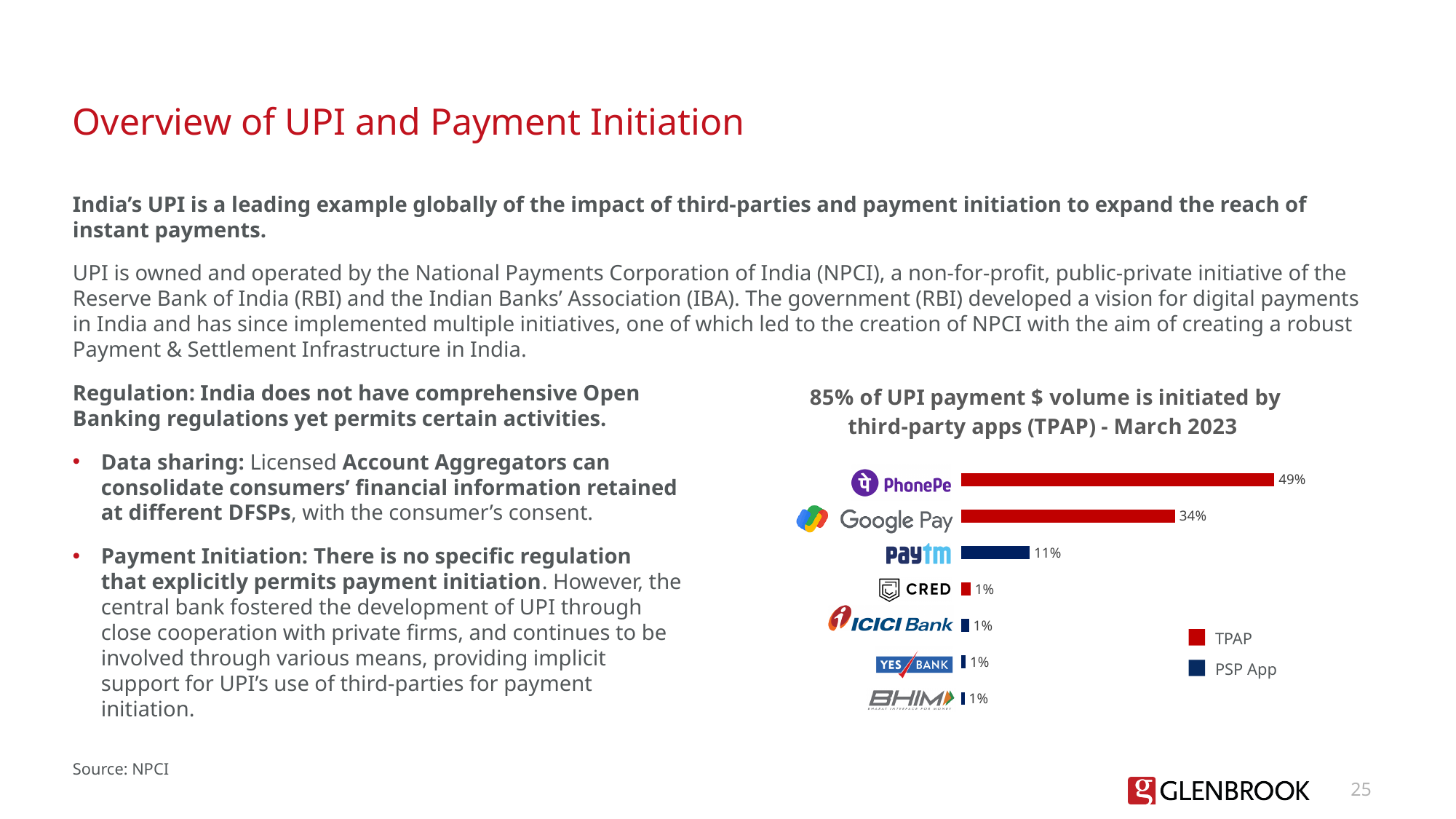
What share of UPI payment volume is initiated by PhonePe? 49% What is the value shown for CRED? 1% What is the value shown for Paytm? 11% How many series does the legend list? 2 What kind of chart is shown on the slide? Bar chart What is the value shown for Google Pay? 34% Which is larger, the value for Paytm or the value for Google Pay? Google Pay What is the difference between the Google Pay and Paytm values? 23% How many apps are shown in the chart? 7 Which legend entry is shown in red? TPAP What is the difference between the PhonePe and Google Pay values? 15% Which app has the highest share of UPI payment volume? PhonePe